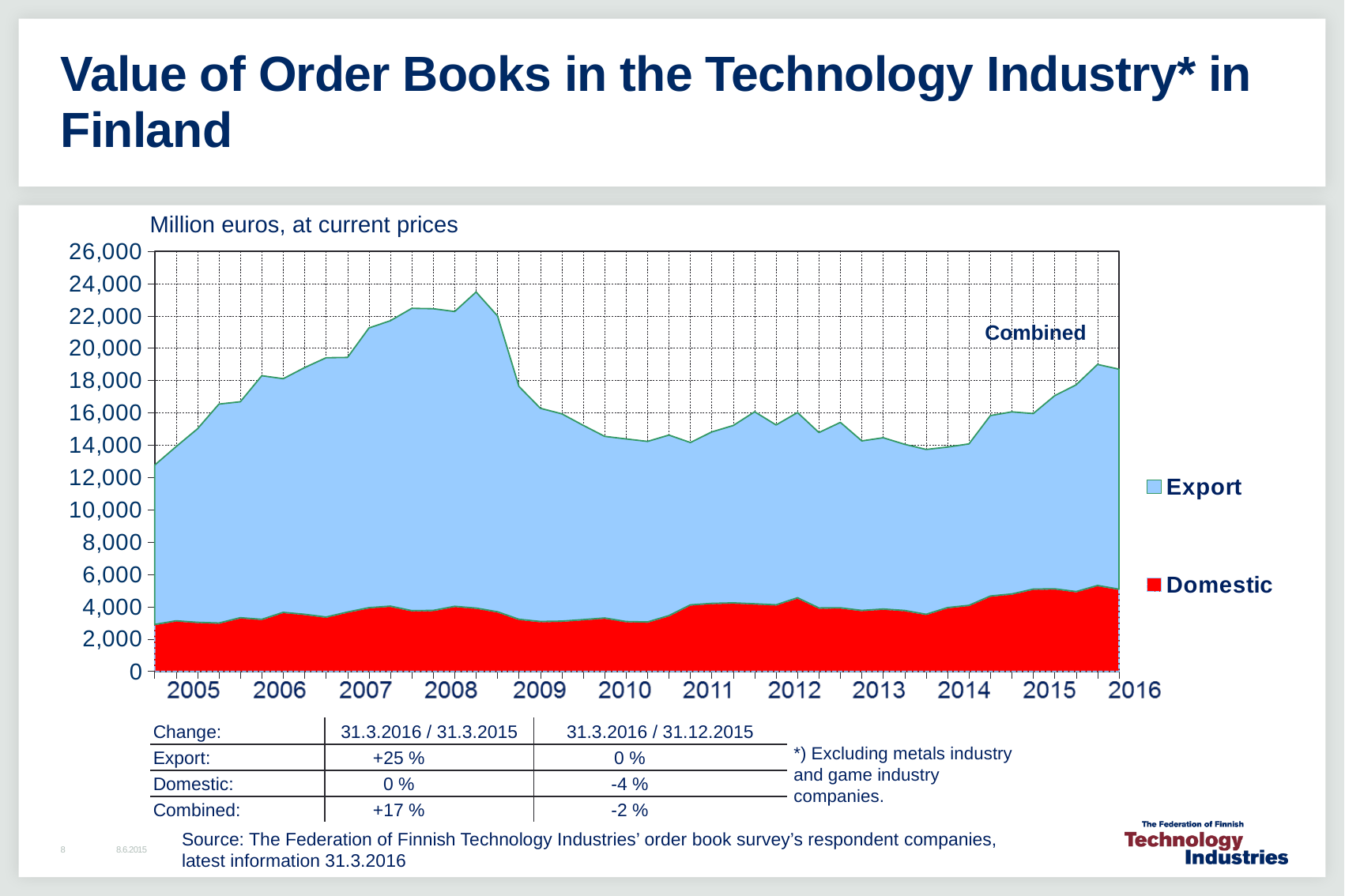
According to the change table, what was the Domestic change for 31.3.2016 / 31.12.2015? -4 % Is the Combined value at the start of 2016 greater or less than 16,000? greater According to the change table, what was the Export change for 31.3.2016 / 31.3.2015? +25 % In which year did the Combined value of order books reach its highest peak? 2008 What unit is the y axis measured in, according to the label above the chart? Million euros, at current prices Is the Domestic value at the start of 2016 greater or less than 4,000? greater Did the Combined value rise or fall between 2008 and 2009? Fall Which colour represents the Domestic series? Red Did the Combined value rise or fall between 2014 and 2016? Rise What kind of chart is used to show the value of order books? Area chart How many series does the legend list? 2